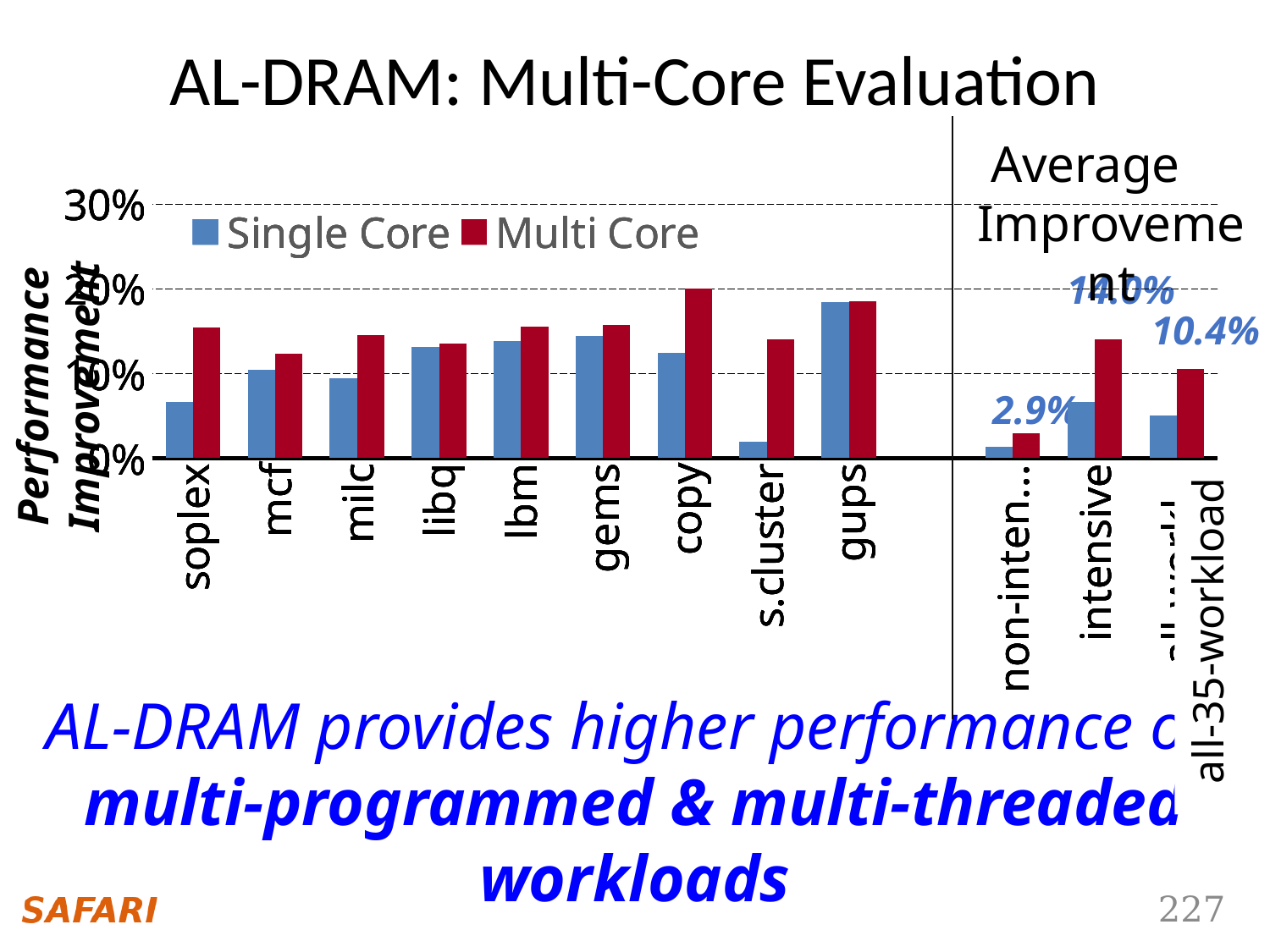
Which category has the highest Single Core performance improvement? gups Is the Single Core value for s.cluster greater or less than 10%? less What kind of chart is shown on the slide? bar chart How many series does the legend list? 2 Which category has the lowest Multi Core performance improvement? non-intensive What is the labeled Multi Core performance improvement for all-35-workload? 10.4% Is the Single Core value for gups greater or less than 10%? greater What are the two series named in the legend? Single Core and Multi Core What is the labeled Multi Core performance improvement for the non-intensive workloads? 2.9% For s.cluster, which is larger: the Single Core or the Multi Core value? Multi Core What is the title of the slide's chart? AL-DRAM: Multi-Core Evaluation For copy, which is larger: the Single Core or the Multi Core value? Multi Core